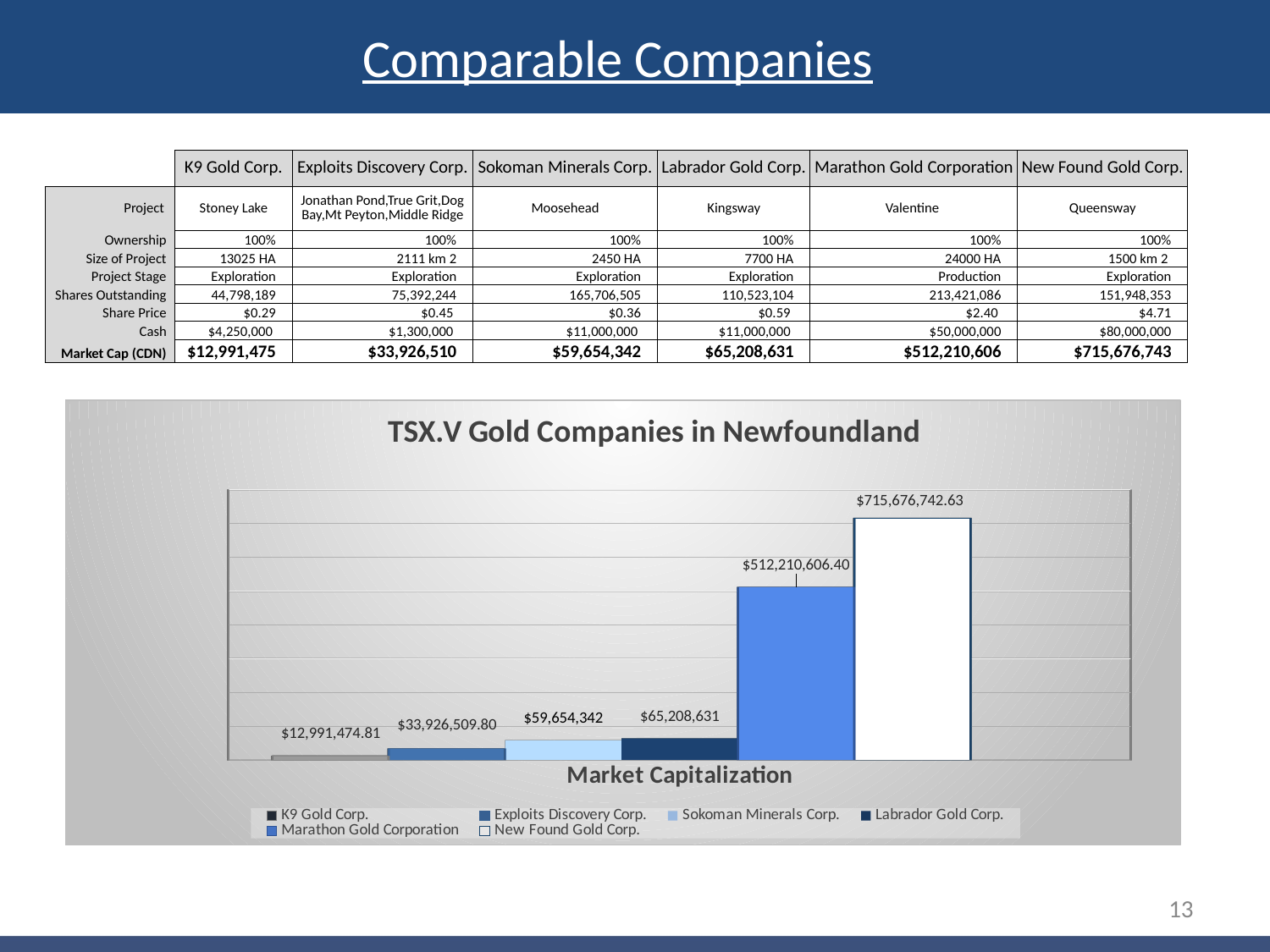
What is the value shown for Sokoman Minerals Corp. in the chart? $59,654,342 What type of chart is shown on the slide? Bar chart What is the category label shown on the x axis of the chart? Market Capitalization What is the difference between the values for Labrador Gold Corp. and Sokoman Minerals Corp. in the chart? $5,554,289 How many series does the chart's legend list? 6 What is the title of the chart on the slide? TSX.V Gold Companies in Newfoundland Which company has the lowest market capitalization in the chart? K9 Gold Corp. What is the value shown for Marathon Gold Corporation in the chart? $512,210,606.40 What is the value shown for K9 Gold Corp. in the chart? $12,991,474.81 What is the value shown for New Found Gold Corp. in the chart? $715,676,742.63 Which has a larger value in the chart, Marathon Gold Corporation or Labrador Gold Corp.? Marathon Gold Corporation Which company has the highest market capitalization in the chart? New Found Gold Corp.